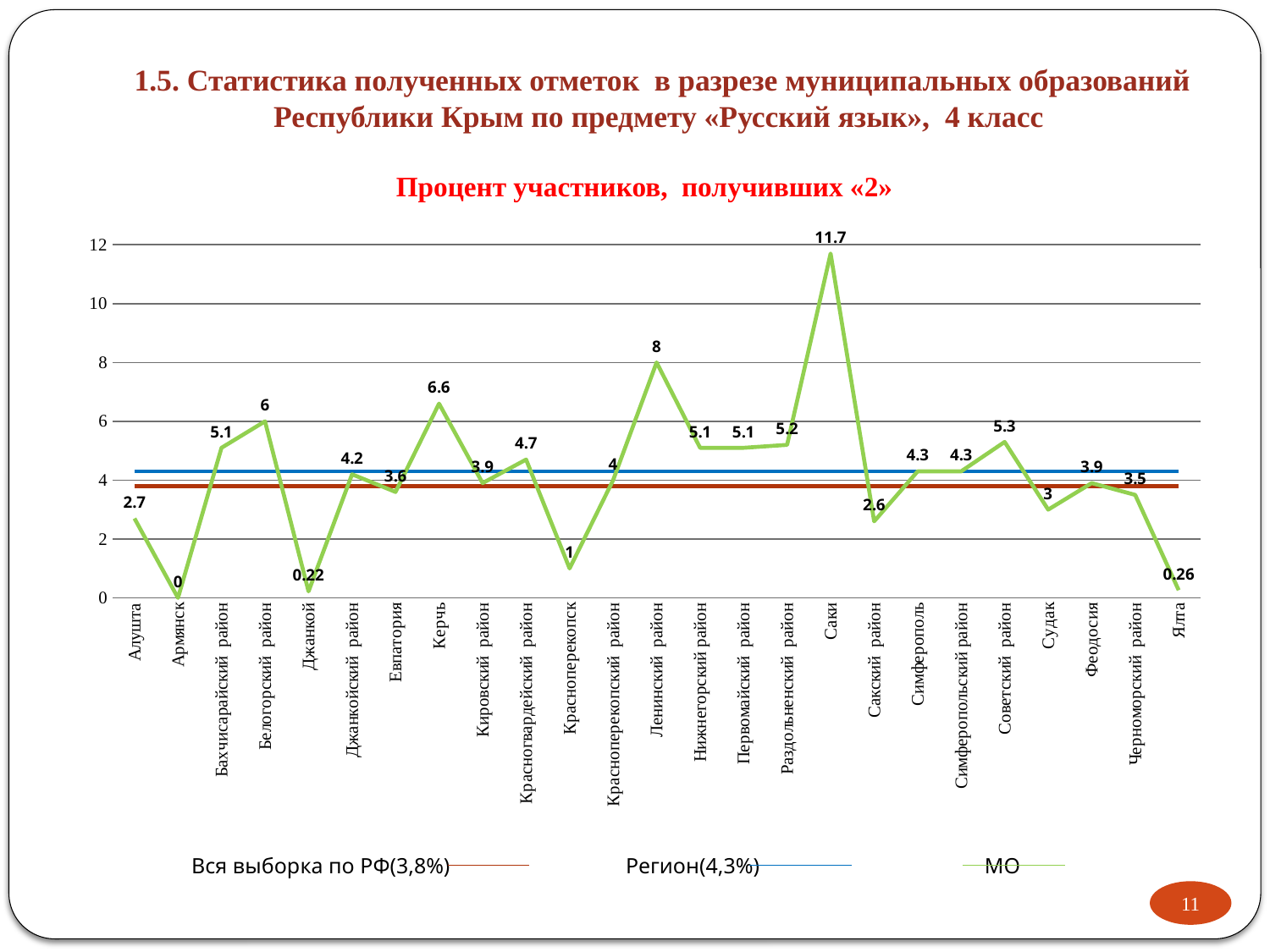
How many series does the legend list? 3 Is the value for Саки greater or less than 10? greater Which municipality has the lowest value on the МО line? Армянск What is the value for Саки? 11.7 What is the value for Ленинский район? 8 Which municipality has the highest value on the МО line? Саки How many municipalities are shown on the x axis? 25 What type of chart is shown on the slide? line chart What is the value for Ялта? 0.26 What is the difference between the values for Саки and Ленинский район? 3.7 What is the value for Керчь? 6.6 Which is larger, the value for Керчь or the value for Белогорский район? Керчь